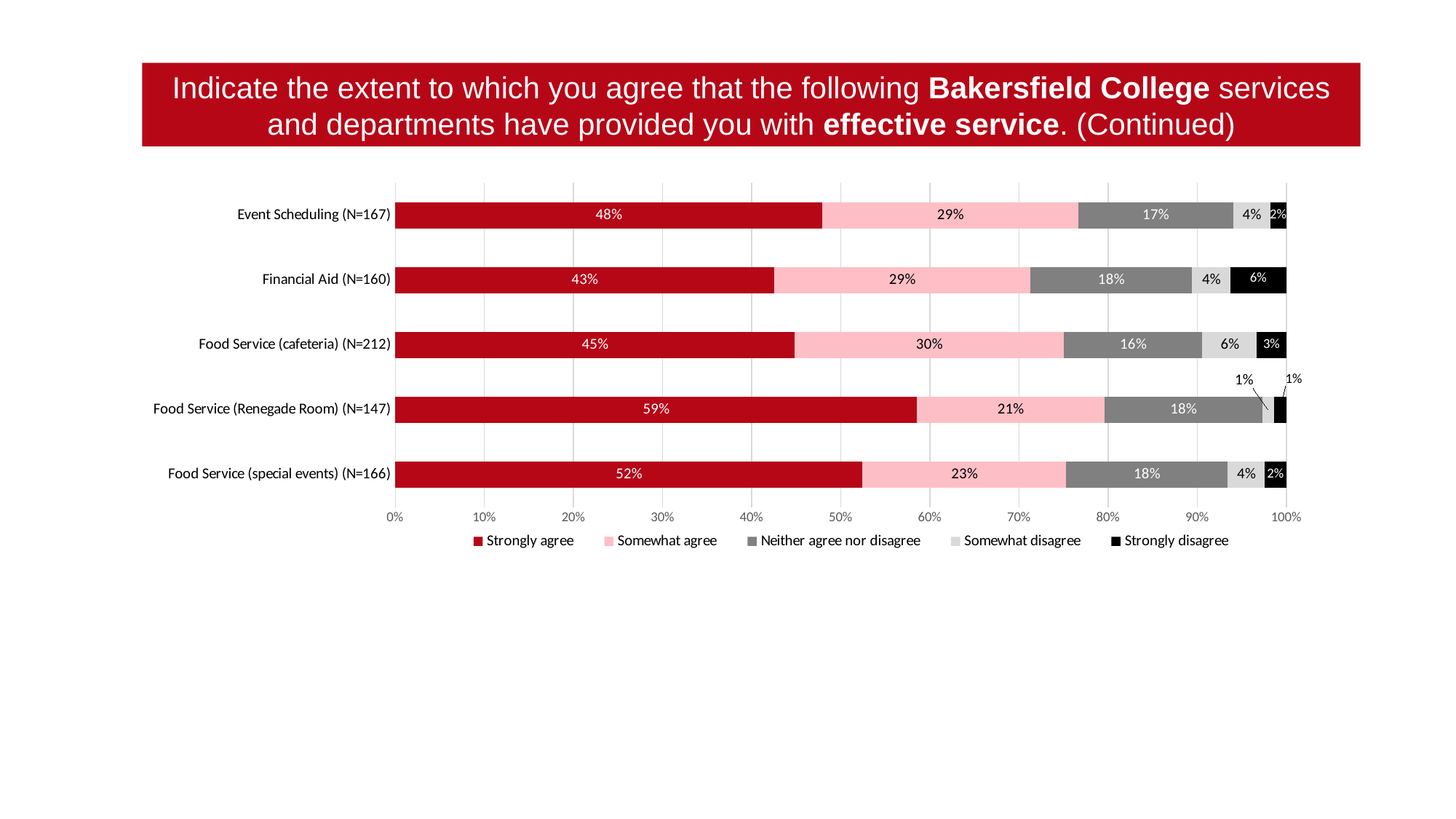
What is the total of the stacked bar for Food Service (cafeteria) (N=212)? 100% Which is larger: the Somewhat disagree value for Food Service (cafeteria) (N=212) or for Event Scheduling (N=167)? Food Service (cafeteria) (N=212) Which service has the lowest Strongly agree percentage? Financial Aid (N=160) Which service has the highest Strongly agree percentage? Food Service (Renegade Room) (N=147) What is the Somewhat agree value for Food Service (cafeteria) (N=212)? 30% How many services or departments are shown in the chart? 5 How many series does the legend list? 5 What is the difference between the Strongly agree values for Food Service (Renegade Room) (N=147) and Food Service (special events) (N=166)? 7% What percentage of respondents strongly agree that Financial Aid (N=160) provided effective service? 43% What is the Strongly disagree value for Financial Aid (N=160)? 6% What kind of chart is shown on the slide? Stacked bar chart What is the Neither agree nor disagree value for Event Scheduling (N=167)? 17%